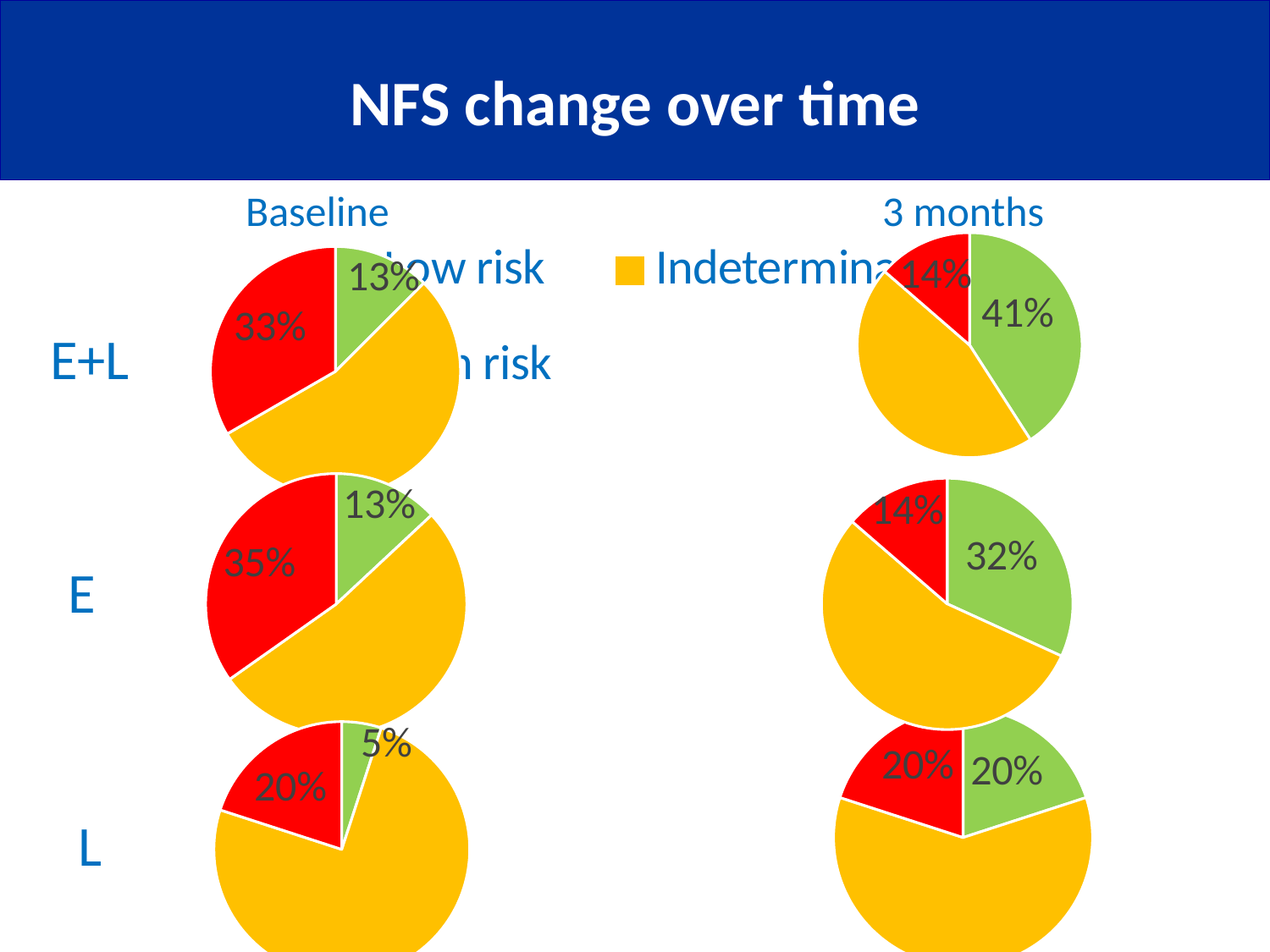
For the E+L row, what is the difference between the green slice at 3 months and the green slice at Baseline? 28% What is the title of the slide? NFS change over time How many pie charts are shown on the slide? 6 In the E 3 months pie chart, what percentage is shown for the green slice? 32% In the L Baseline pie chart, what percentage is shown for the green slice? 5% What kind of charts are shown on the slide? Pie charts In the E+L Baseline pie chart, what percentage is shown for the red slice? 33% For the E+L row, is the green slice larger at Baseline or at 3 months? 3 months For the E row, what is the difference between the red slice at Baseline and the red slice at 3 months? 21% In the E+L 3 months pie chart, what percentage is shown for the green slice? 41% In the L 3 months pie chart, what percentage is shown for the red slice? 20% In the E Baseline pie chart, what percentage is shown for the red slice? 35%